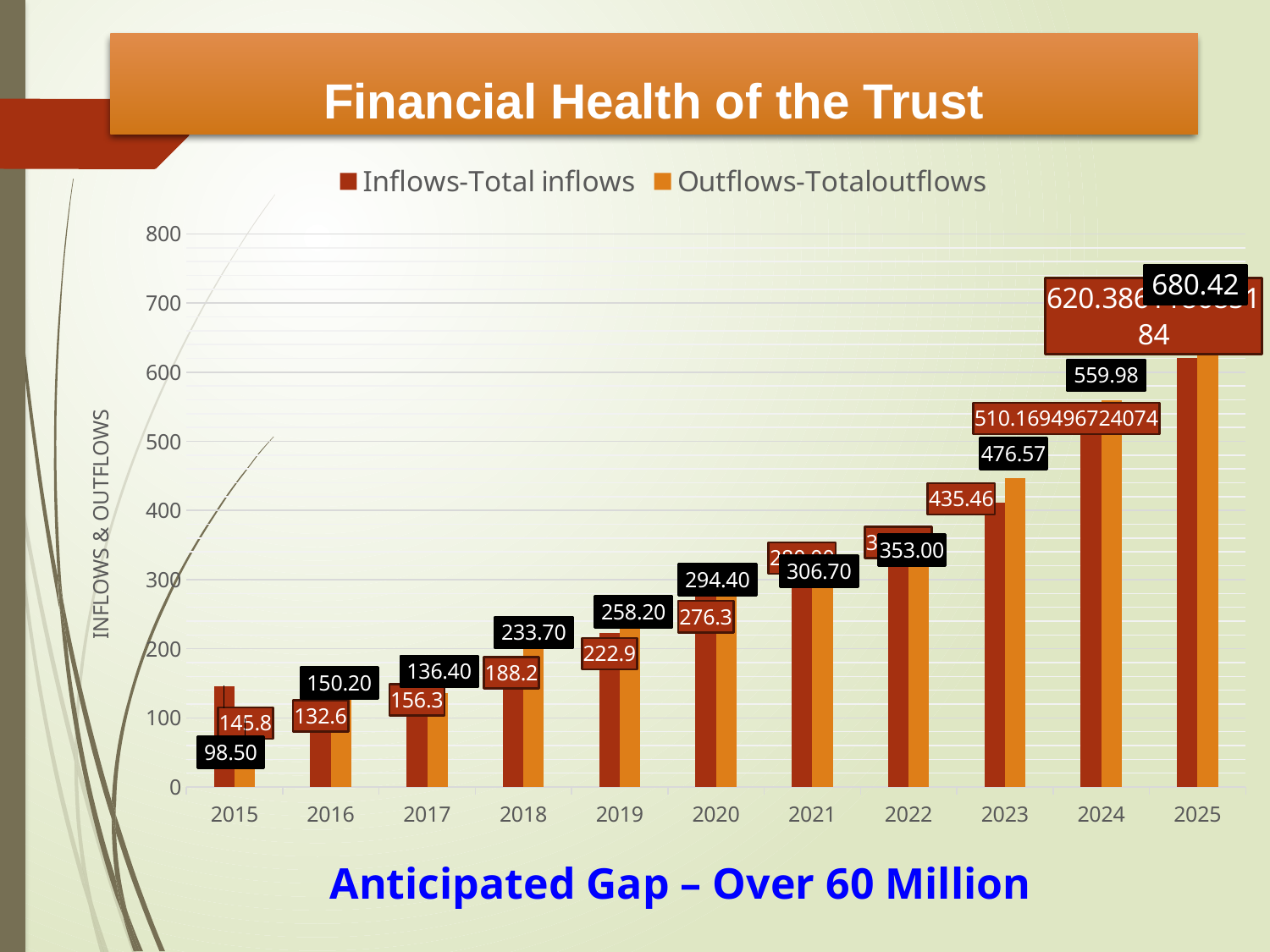
What kind of chart is shown on the slide? bar chart What is the title of the chart? Financial Health of the Trust Is the value of Outflows-Totaloutflows for 2025 greater or less than 600? greater In 2024, which is larger: Inflows-Total inflows or Outflows-Totaloutflows? Outflows-Totaloutflows How many years are shown along the x axis? 11 Which year has the highest Outflows-Totaloutflows value? 2025 How many series does the legend list? 2 What is the label on the vertical axis? INFLOWS & OUTFLOWS What is the value of Outflows-Totaloutflows for 2023? 476.57 What is the difference between Outflows-Totaloutflows and Inflows-Total inflows in 2023? 41.11 What is the value of Outflows-Totaloutflows for 2024? 559.98 What is the value of Inflows-Total inflows for 2024? 510.169496724074